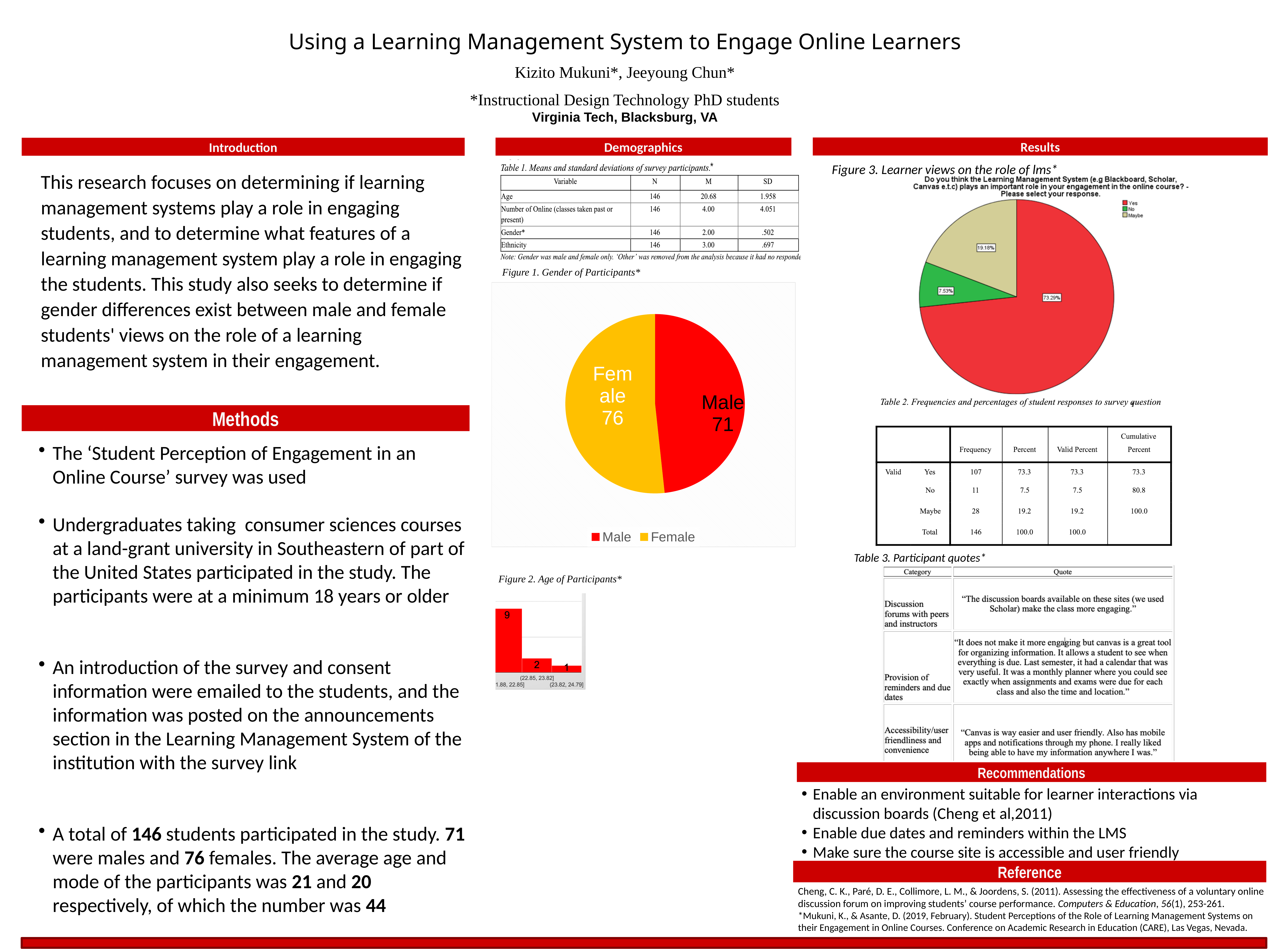
In Figure 3 (Learner views on the role of lms), what percentage of responses is Maybe? 19.18% In Figure 1 (Gender of Participants), which category has the larger value, Male or Female? Female In Figure 1 (Gender of Participants), what is the difference between the Female and Male values? 5 How many entries does the legend of Figure 1 (Gender of Participants) list? 2 In Figure 3 (Learner views on the role of lms), which response has the smallest share? No What kind of chart is Figure 1 (Gender of Participants)? Pie chart In Figure 1 (Gender of Participants), what is the value for Male? 71 In Figure 1 (Gender of Participants), what is the total of the two slices? 147 In Figure 3 (Learner views on the role of lms), what percentage of responses is Yes? 73.29% In Figure 2 (Age of Participants), what is the value of the tallest bar? 9 In Figure 3 (Learner views on the role of lms), what colour is the Yes slice? Red In Figure 1 (Gender of Participants), what is the value for Female? 76